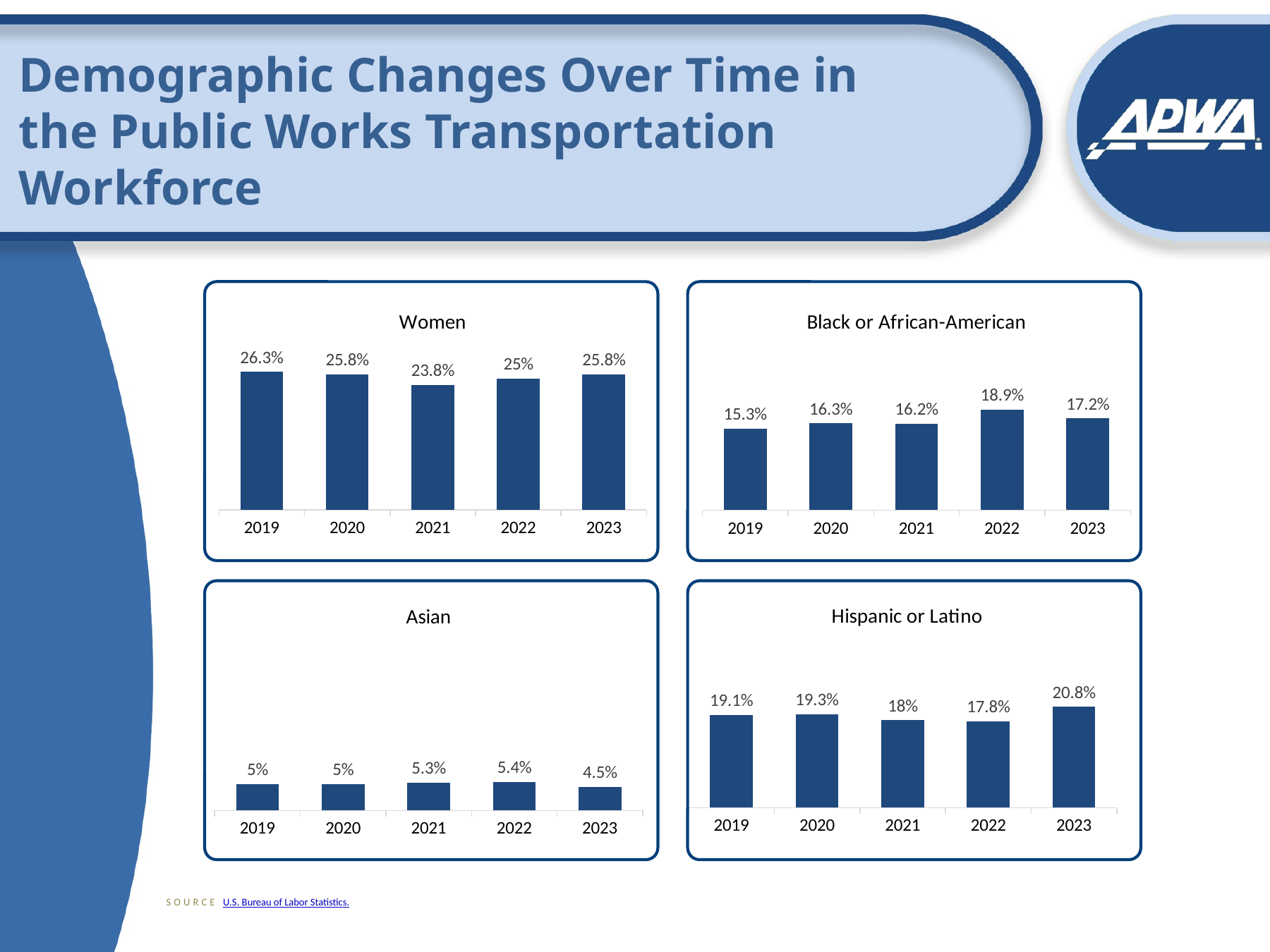
In the "Women" chart, what is the value for 2019? 26.3% What kind of chart is the "Hispanic or Latino" chart? bar chart In the "Asian" chart, what is the value for 2022? 5.4% In the "Black or African-American" chart, is the value for 2022 larger or smaller than the value for 2023? larger In the "Asian" chart, which year has the lowest value? 2023 In the "Hispanic or Latino" chart, what is the value for 2023? 20.8% How many years are shown in the "Asian" chart? 5 How many charts are shown on the slide? 4 In the "Black or African-American" chart, which year has the highest value? 2022 In the "Women" chart, what is the difference between the 2019 value and the 2021 value? 2.5% In the "Black or African-American" chart, what is the value for 2019? 15.3% In the "Hispanic or Latino" chart, what is the difference between the 2023 value and the 2022 value? 3%